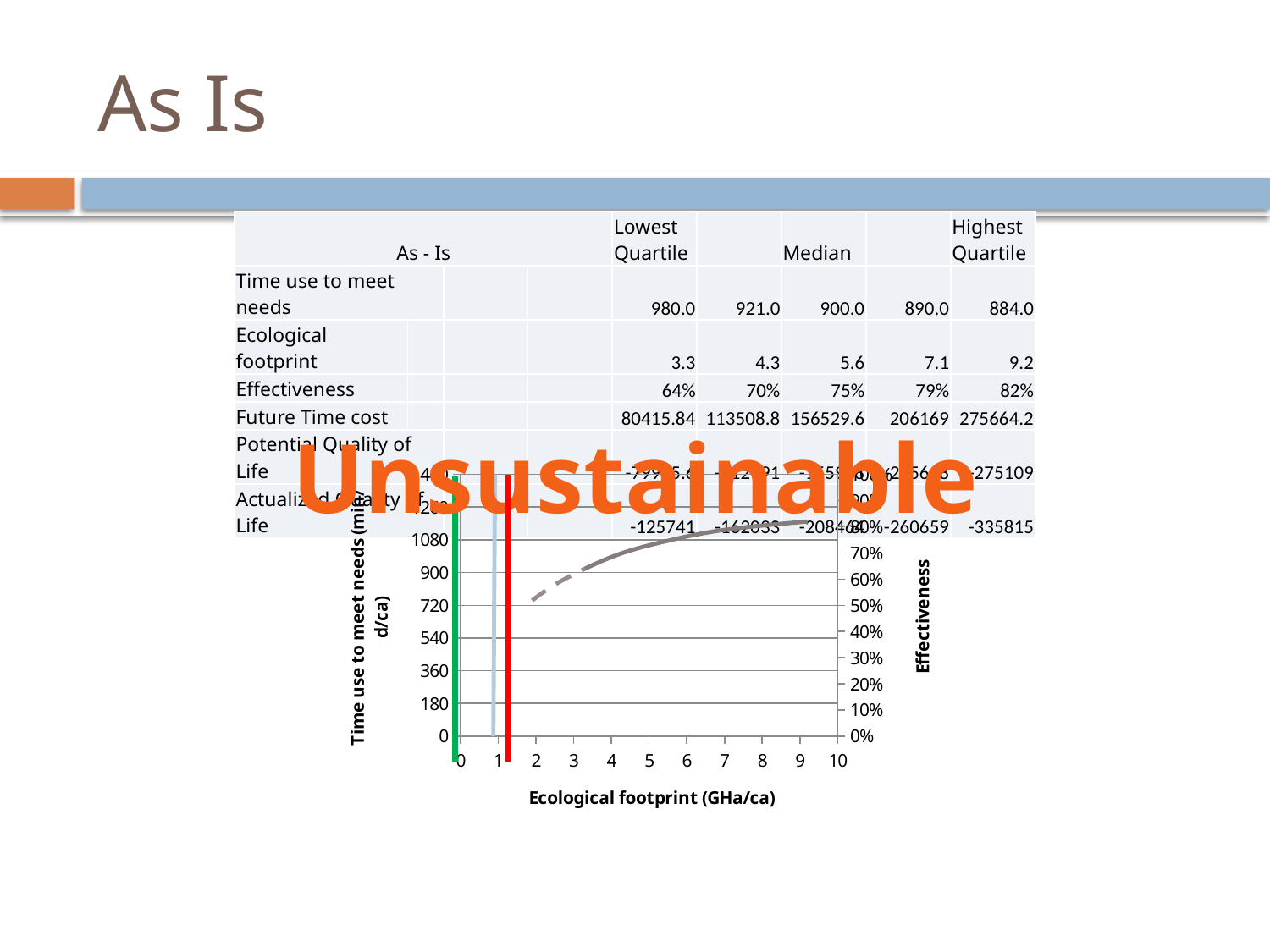
Does the dashed curve rise or fall as the ecological footprint increases along the x axis? rise Is the value of the dashed curve at an ecological footprint of 3 greater or less than 720 on the left axis? greater What kind of chart is shown on the slide? line chart What is the highest tick value shown on the x axis of the chart? 10 Is the value of the dashed curve at an ecological footprint of 6 greater or less than 900 on the left axis? greater What is the title of the right-hand y axis of the chart? Effectiveness What is the title of the x axis of the chart? Ecological footprint (GHa/ca)